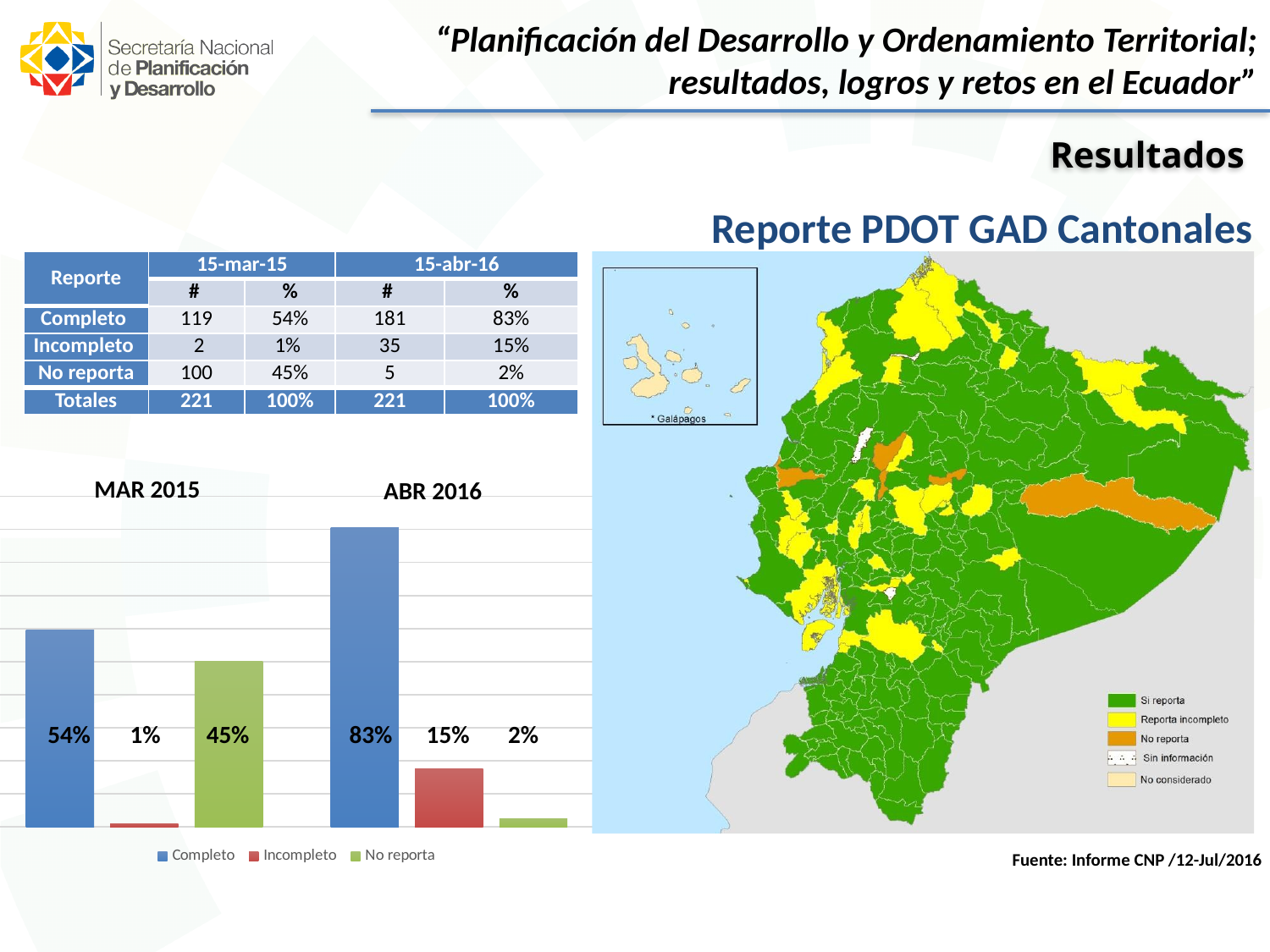
How many category groups are shown on the x axis of the bar chart? 2 How many series does the legend of the bar chart list? 3 In the bar chart, what colour are the Incompleto bars? red In the bar chart, what is the value for Completo in MAR 2015? 54% In the bar chart, which series has the highest value in ABR 2016? Completo In the bar chart, what is the value for No reporta in MAR 2015? 45% In the bar chart, what is the difference between the Completo values for ABR 2016 and MAR 2015? 29% What type of chart is shown at the bottom left of the slide? bar chart In the bar chart, which series has the lowest value in MAR 2015? Incompleto In the bar chart, what is the value for Incompleto in ABR 2016? 15% In the bar chart, which is larger: No reporta in MAR 2015 or Incompleto in ABR 2016? No reporta in MAR 2015 In the bar chart, what is the value for No reporta in ABR 2016? 2%